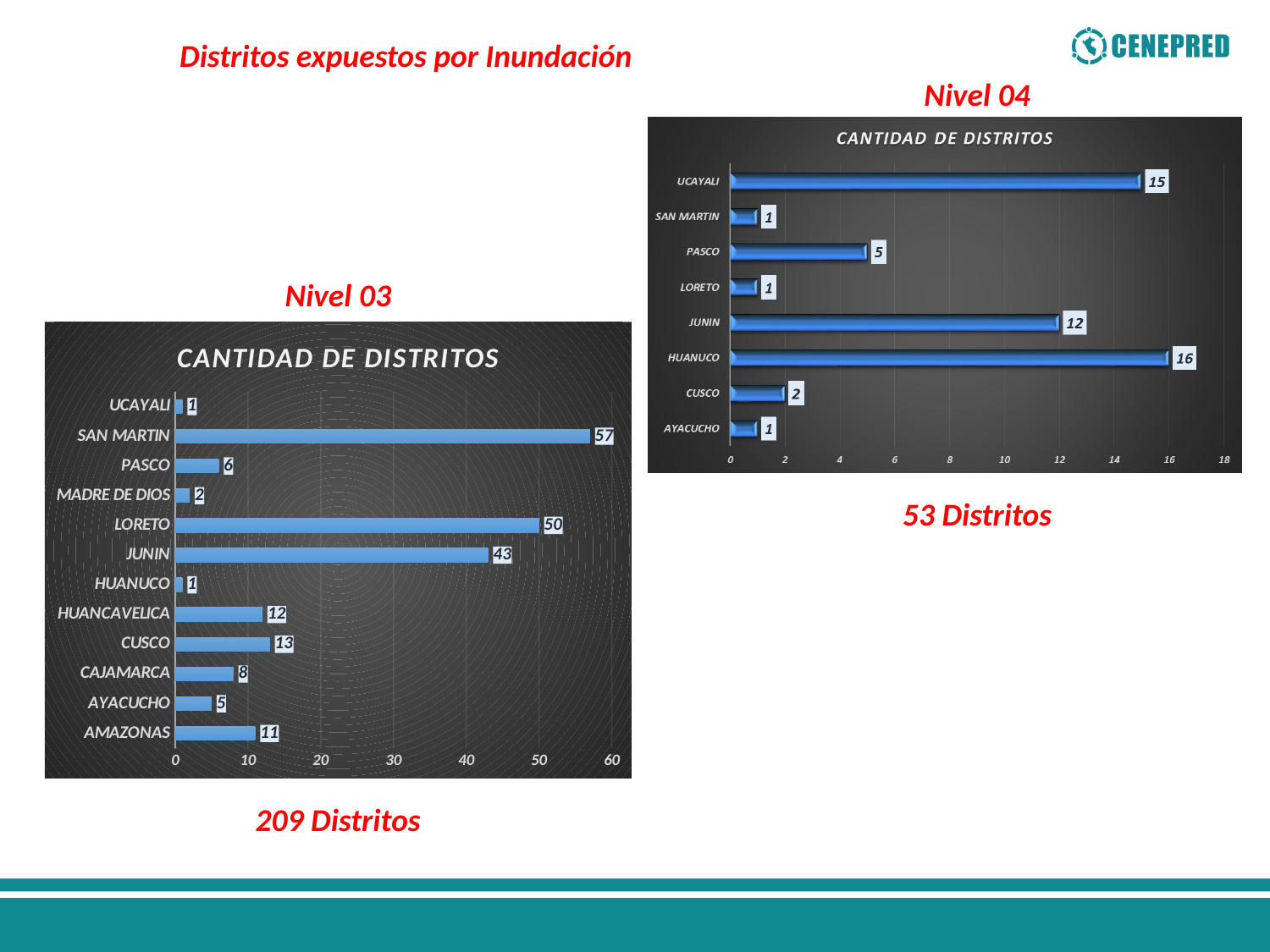
In the Nivel 03 chart, which is larger, the value for CUSCO or the value for HUANCAVELICA? CUSCO In the Nivel 03 chart, what is the difference between the values for LORETO and JUNIN? 7 In the Nivel 03 chart, what is the value for JUNIN? 43 In the Nivel 04 chart, what is the value for PASCO? 5 In the Nivel 04 chart, what is the value for HUANUCO? 16 In the Nivel 03 chart, which category has the highest value? SAN MARTIN How many categories are shown in the Nivel 03 chart? 12 In the Nivel 03 chart, what is the value for SAN MARTIN? 57 What type of chart is the Nivel 03 chart? Bar chart In the Nivel 04 chart, which category has the highest value? HUANUCO In the Nivel 04 chart, what is the difference between the values for UCAYALI and JUNIN? 3 How many categories are shown in the Nivel 04 chart? 8